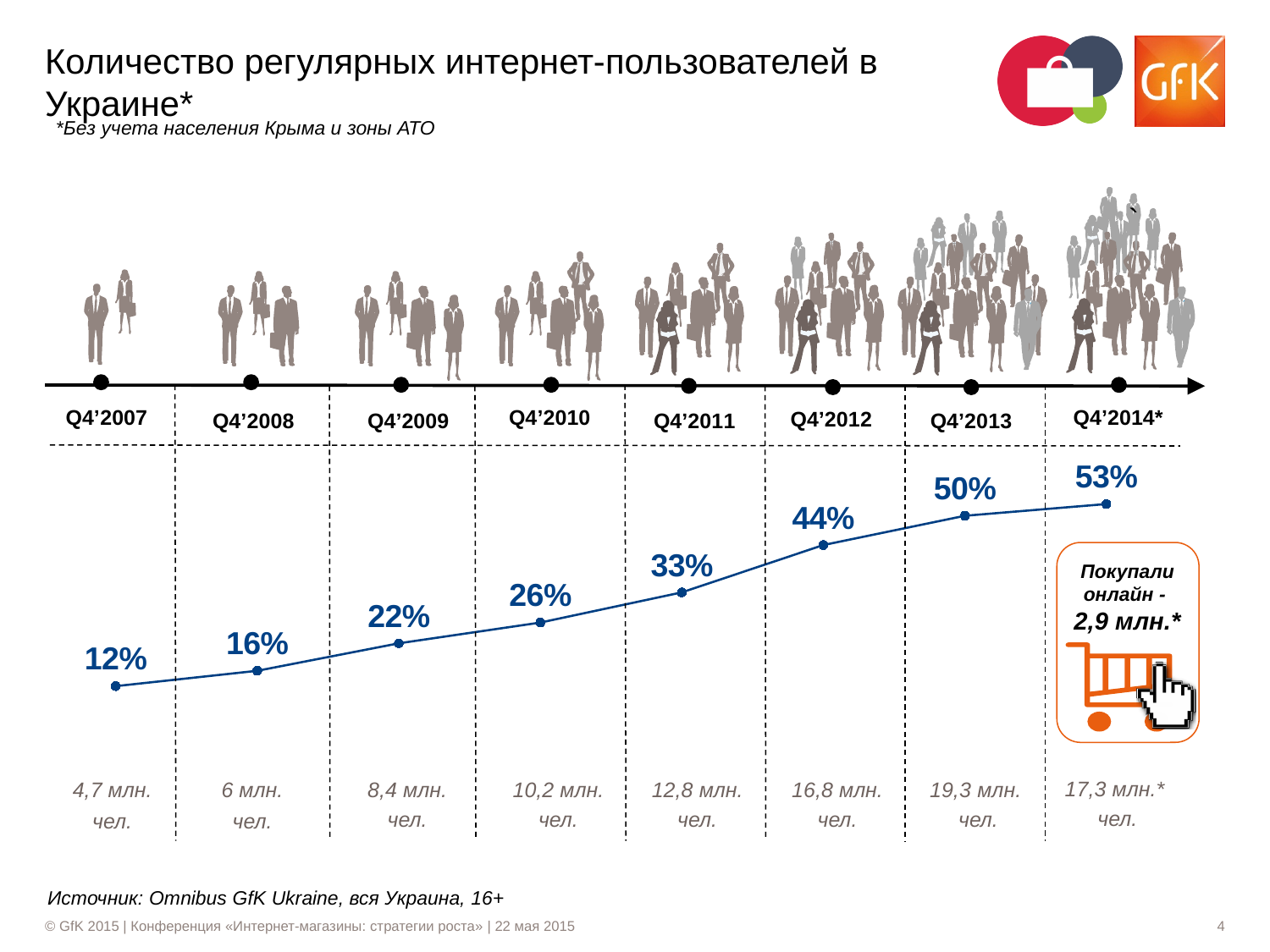
Which period has the lowest percentage of regular internet users? Q4'2007 What percentage is shown for Q4'2012? 44% What is the difference in percentage points between Q4'2011 and Q4'2007? 21 How many million people are shown for Q4'2013? 19,3 млн. чел. Which period has the highest percentage of regular internet users? Q4'2014* What kind of chart is used to show the percentages? line chart What is the value for Q4'2014*? 53% What percentage of regular internet users is shown for Q4'2007? 12% How many time periods are plotted on the chart? 8 What is the difference in percentage points between Q4'2013 and Q4'2012? 6 Do the percentage values rise or fall from Q4'2007 to Q4'2014*? rise Which is larger, the value for Q4'2009 or the value for Q4'2010? Q4'2010